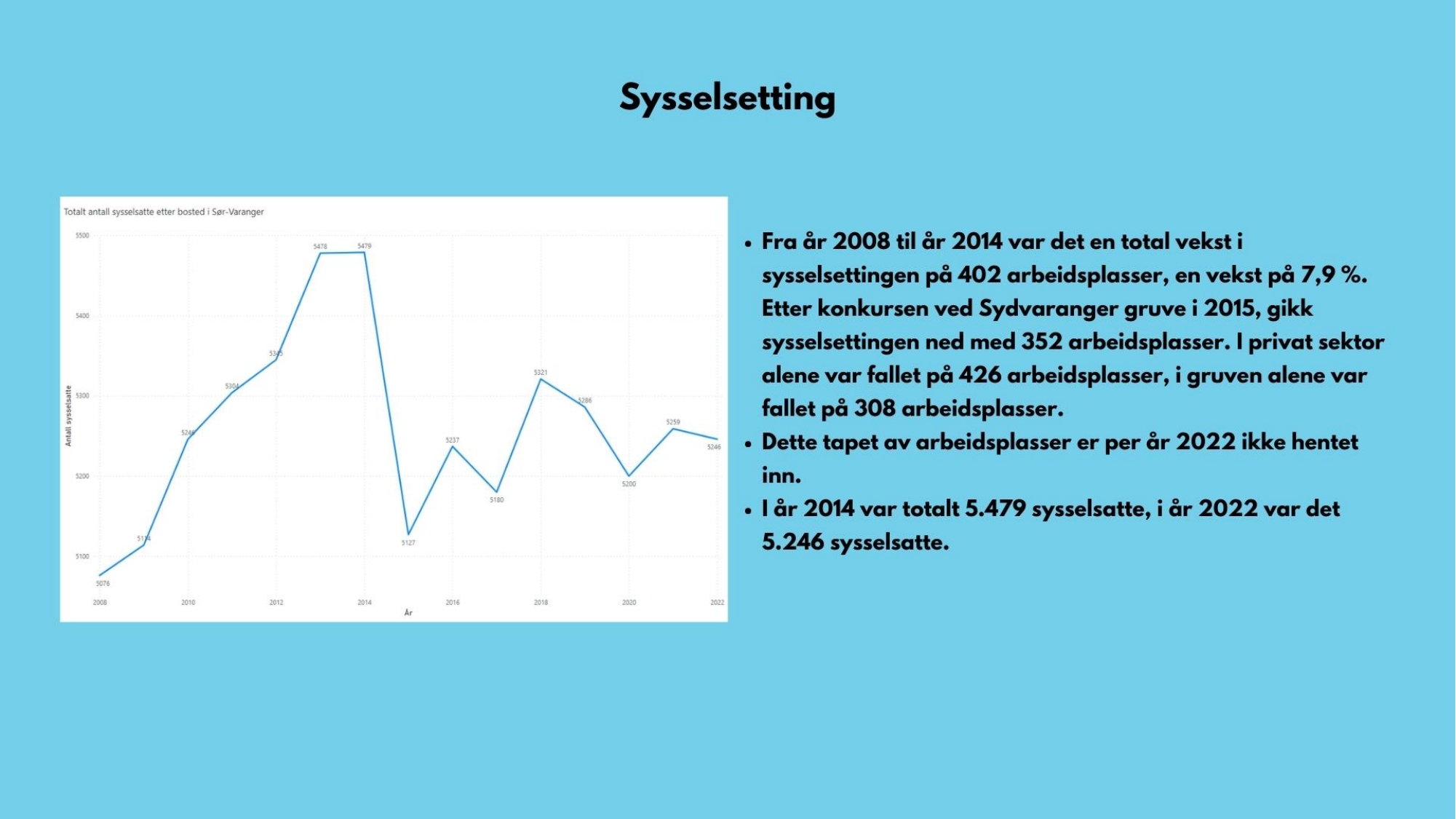
What kind of chart is shown on the slide? Line chart What is the value for 2015? 5127 What is the value for 2018? 5321 How many years are plotted on the x axis? 15 Which year has the lowest value? 2008 What is the difference between the values for 2014 and 2015? 352 What is the value for 2022? 5246 Is the value for 2013 greater or less than 5400? greater Which is larger, the value for 2016 or the value for 2018? 2018 What is the value for 2008? 5076 Do the values rise or fall from 2008 to 2014? Rise What is the title of the chart? Totalt antall sysselsatte etter bosted i Sør-Varanger